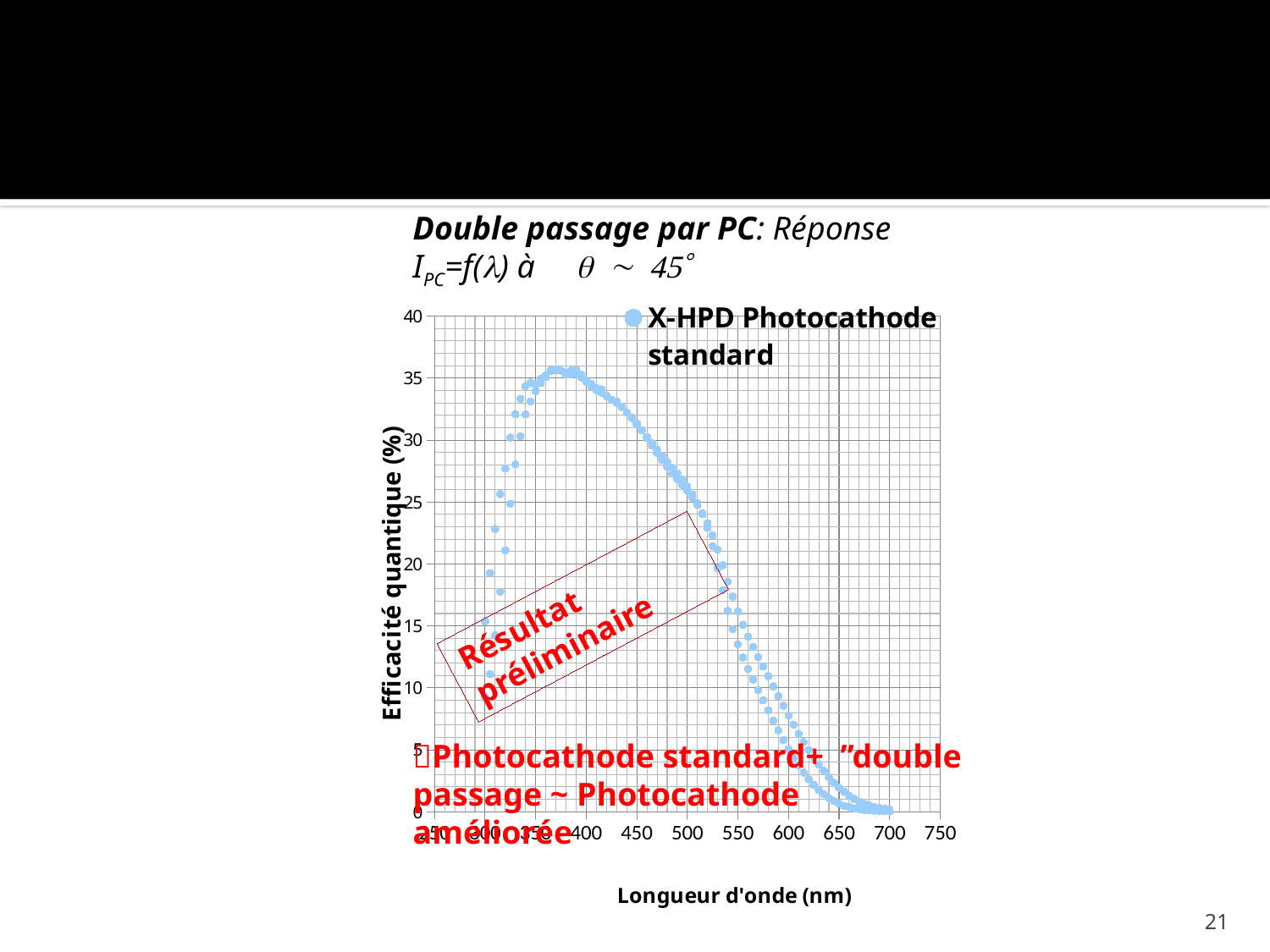
Is the quantum efficiency at 350 nm greater or less than 30? greater Do the quantum efficiency values rise or fall as the wavelength increases from 400 nm to 700 nm? fall How many series does the chart legend list? 1 Is the quantum efficiency at 500 nm greater or less than 20? greater Which has the higher quantum efficiency, 400 nm or 600 nm? 400 nm Is the quantum efficiency at 600 nm greater or less than 15? less What is the name of the series shown in the chart legend? X-HPD Photocathode standard What kind of chart is shown on the slide? scatter chart What is the title of the x axis of the chart? Longueur d'onde (nm) Which has the lower quantum efficiency, 450 nm or 650 nm? 650 nm